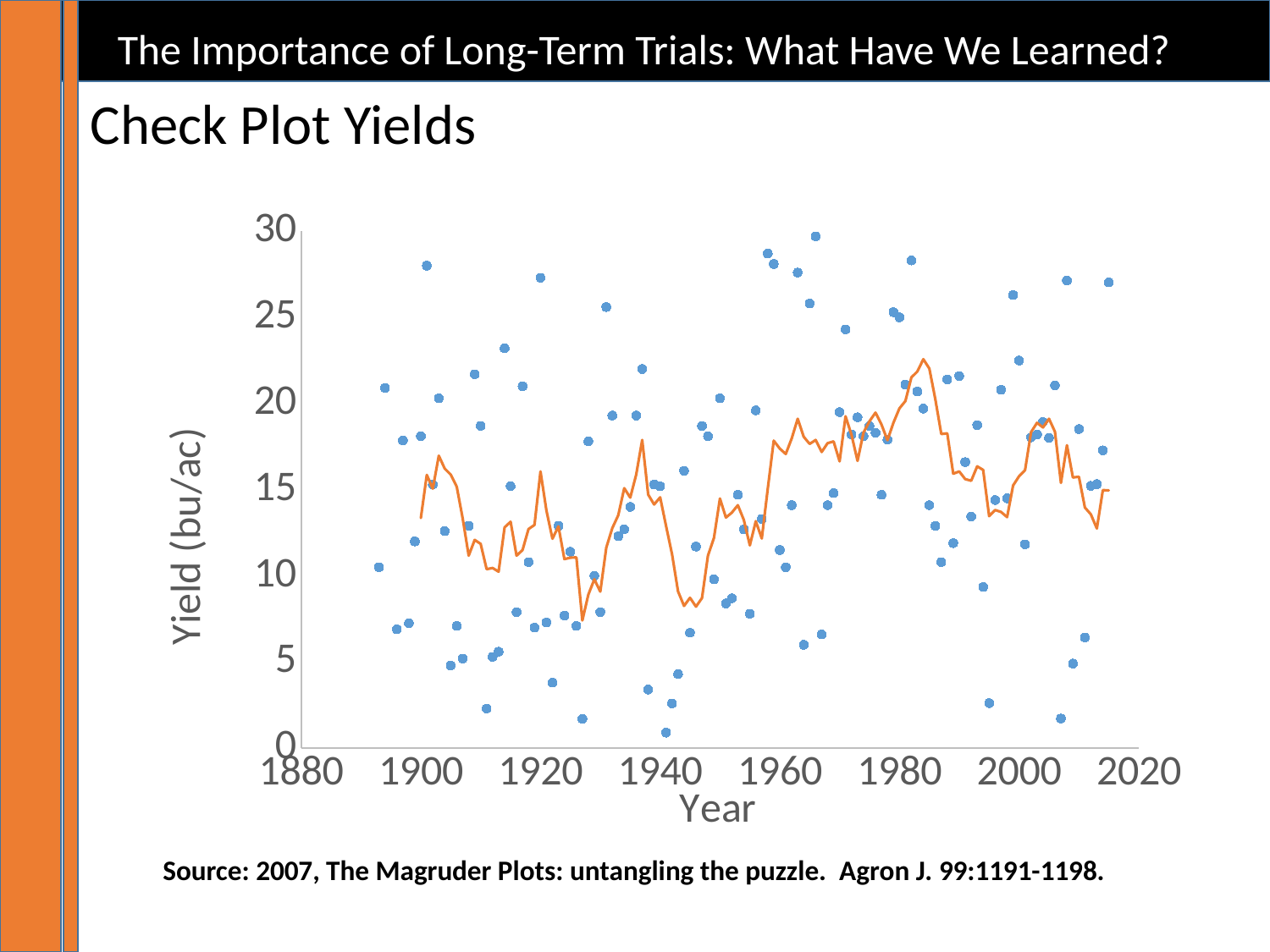
What is the title of the chart on the slide? Check Plot Yields What kind of chart is shown on the slide? scatter chart Is the peak of the orange line greater or less than 20? greater Is the lowest point of the orange line greater or less than 10? less What is the label on the vertical axis of the chart? Yield (bu/ac) Does the orange line generally rise or fall between 1985 and 1995? fall Does the orange line generally rise or fall between 1945 and 1985? rise Does the orange line ever rise above 25? no